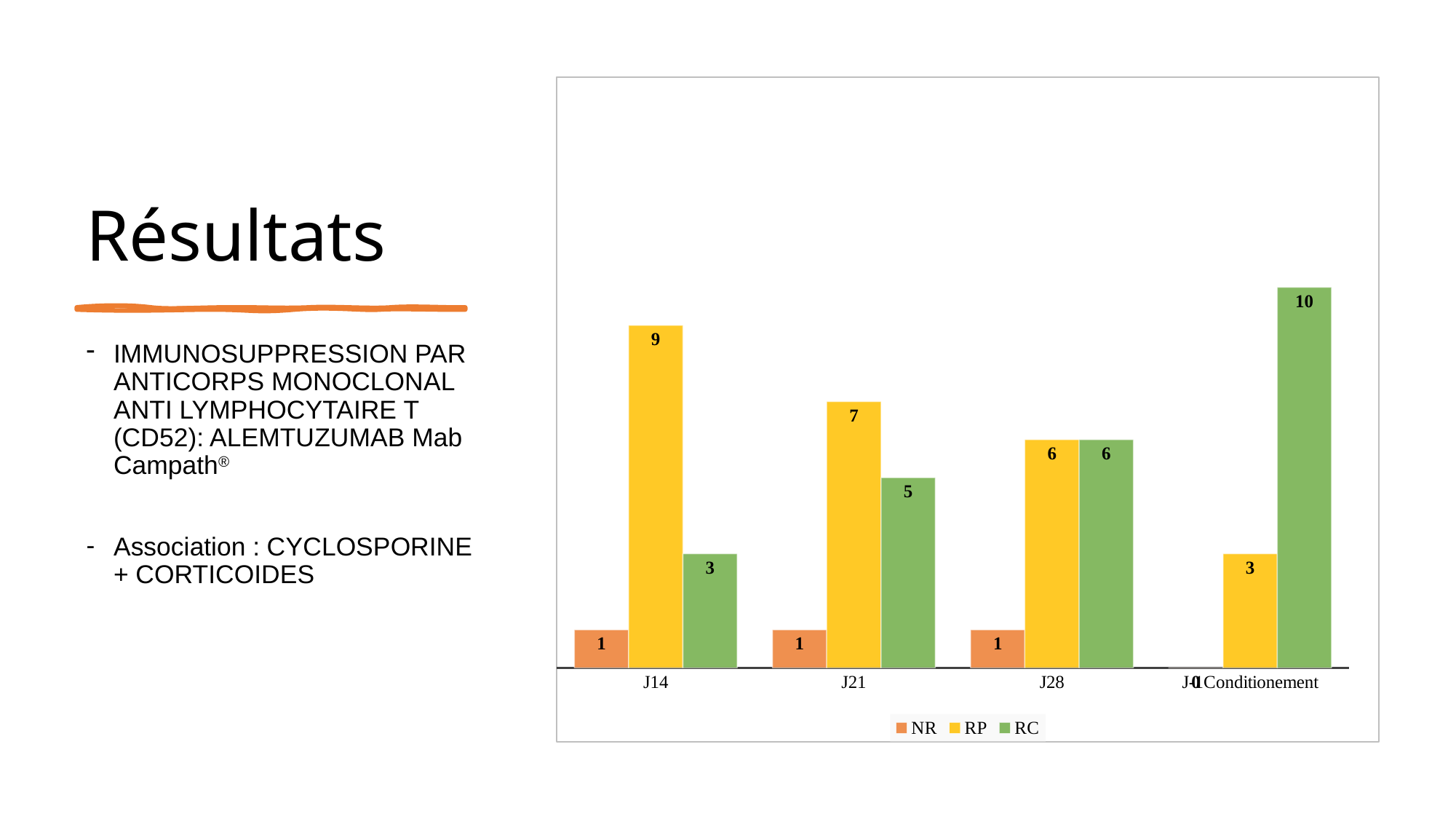
Which is larger at J21, RP or RC? RP Which series has the highest value at J14? RP What is the value of RC in the rightmost category group? 10 What type of chart is shown on the slide? bar chart What is the value of RC at J21? 5 Which series is shown in green in the legend? RC What is the value of RP at J14? 9 How many series does the legend list? 3 What is the value of NR at J28? 1 What is the difference between RP and RC at J14? 6 Which series has the lowest value at J21? NR Does the RP value rise or fall from J14 to J28? fall